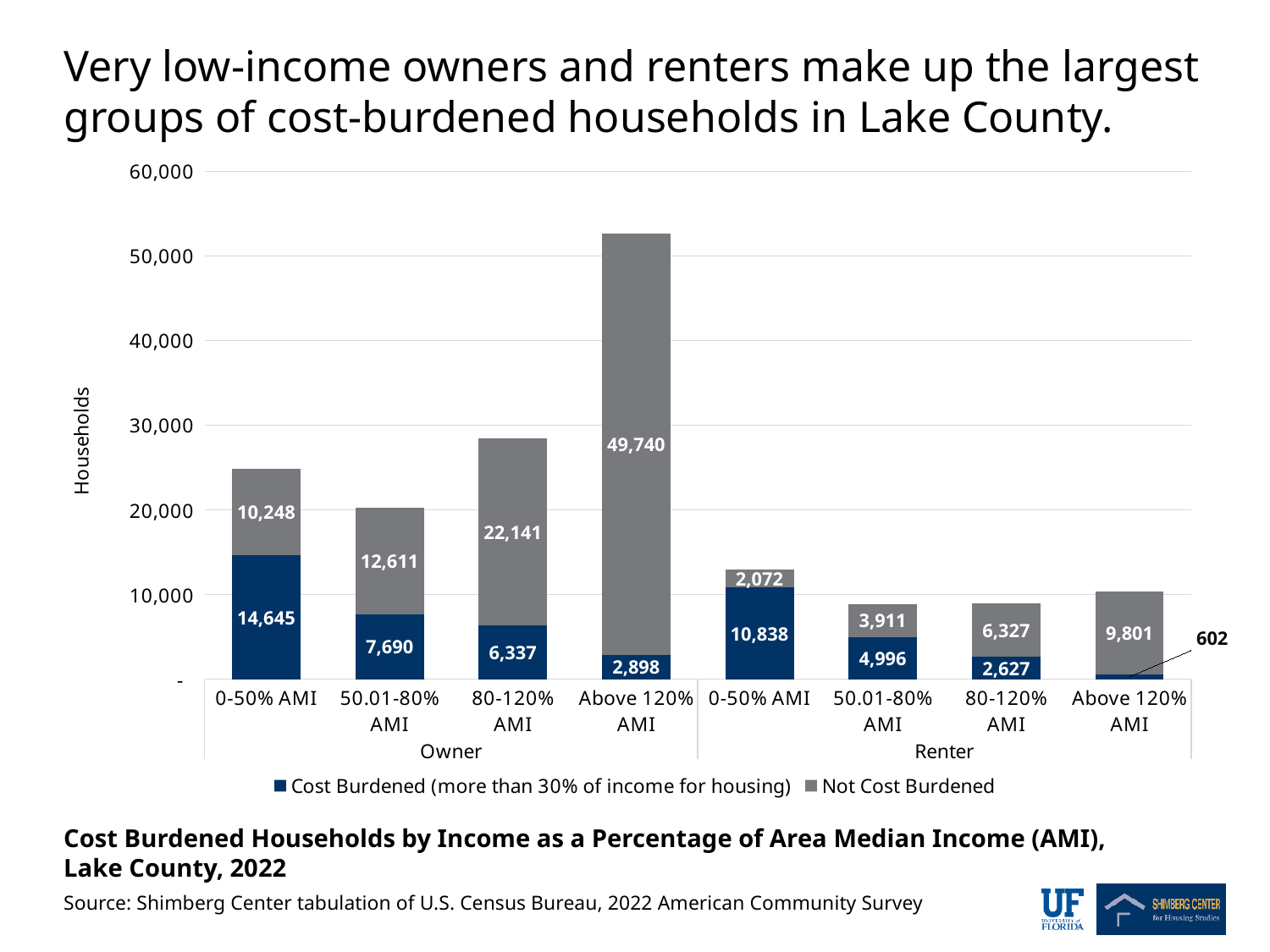
What is the Not Cost Burdened value for owners above 120% AMI? 49,740 Which category has the highest number of cost-burdened households? Owner, 0-50% AMI How many cost-burdened households are there among owners at 0-50% AMI? 14,645 Which category has the lowest number of cost-burdened households? Renter, Above 120% AMI What is the total number of households (cost burdened plus not cost burdened) for owners at 0-50% AMI? 24,893 How many cost-burdened renter households are there at 80-120% AMI? 2,627 What type of chart is shown on the slide? Stacked bar chart Which is larger: the Not Cost Burdened value for renters at 50.01-80% AMI or for renters at 80-120% AMI? Renters at 80-120% AMI How many series does the legend list? 2 What is the difference between cost-burdened owner households and cost-burdened renter households at 0-50% AMI? 3,807 How many income categories (bars) are plotted across the Owner and Renter groups combined? 8 What is the label on the vertical axis of the chart? Households